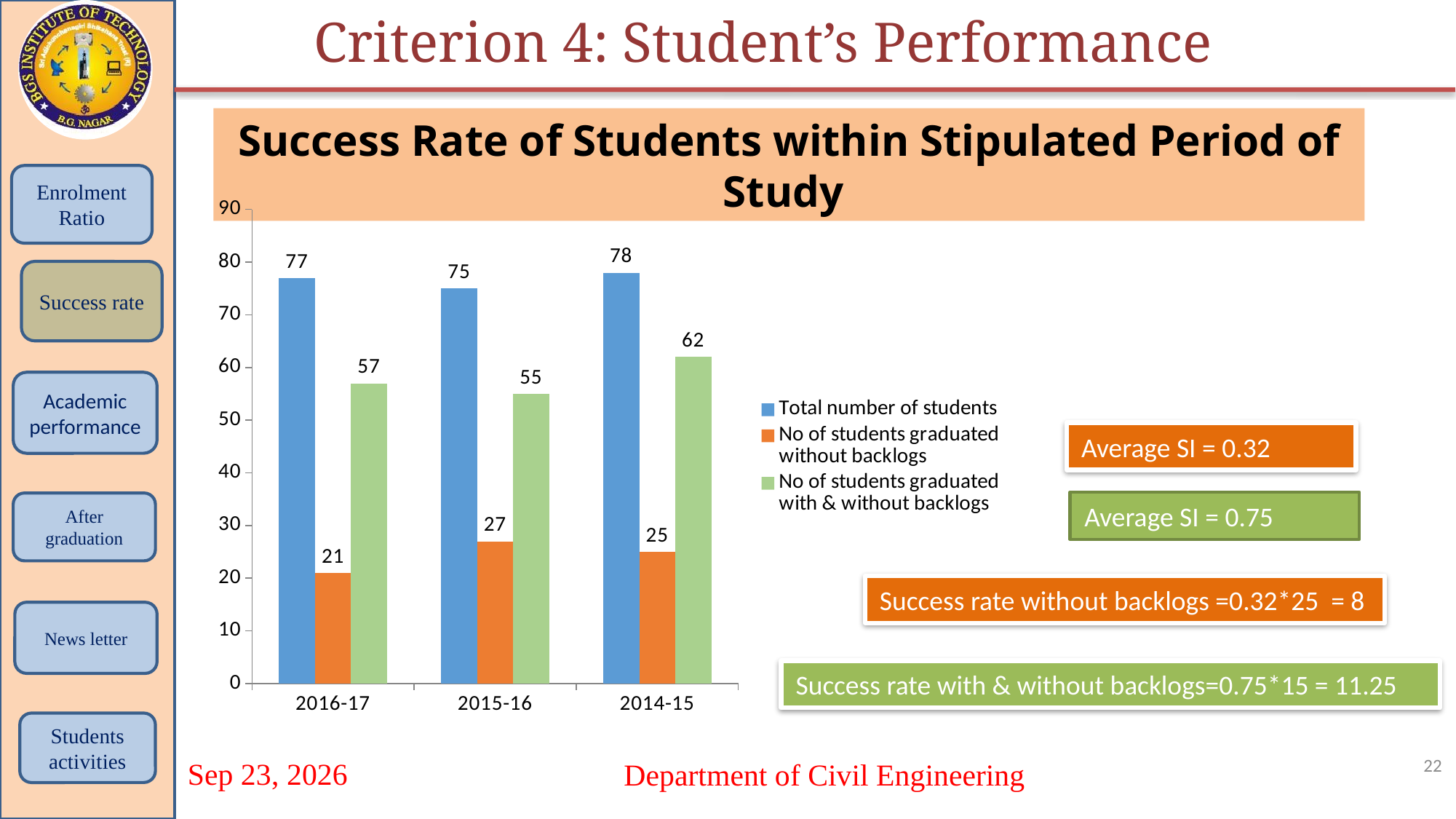
Which colour represents the 'Total number of students' series? Blue What is the difference between the total number of students and the number graduated with & without backlogs in 2015-16? 20 How many students graduated without backlogs in 2015-16? 27 What is the total number of students for 2016-17? 77 Which year has the lowest number of students graduated without backlogs? 2016-17 How many series does the legend list? 3 Which year has the highest total number of students? 2014-15 How many year categories are shown on the x axis? 3 Which is larger: the number of students graduated with & without backlogs in 2016-17 or in 2014-15? 2014-15 What kind of chart is shown on the slide? Bar chart What is the title of the chart? Success Rate of Students within Stipulated Period of Study How many students graduated with & without backlogs in 2014-15? 62